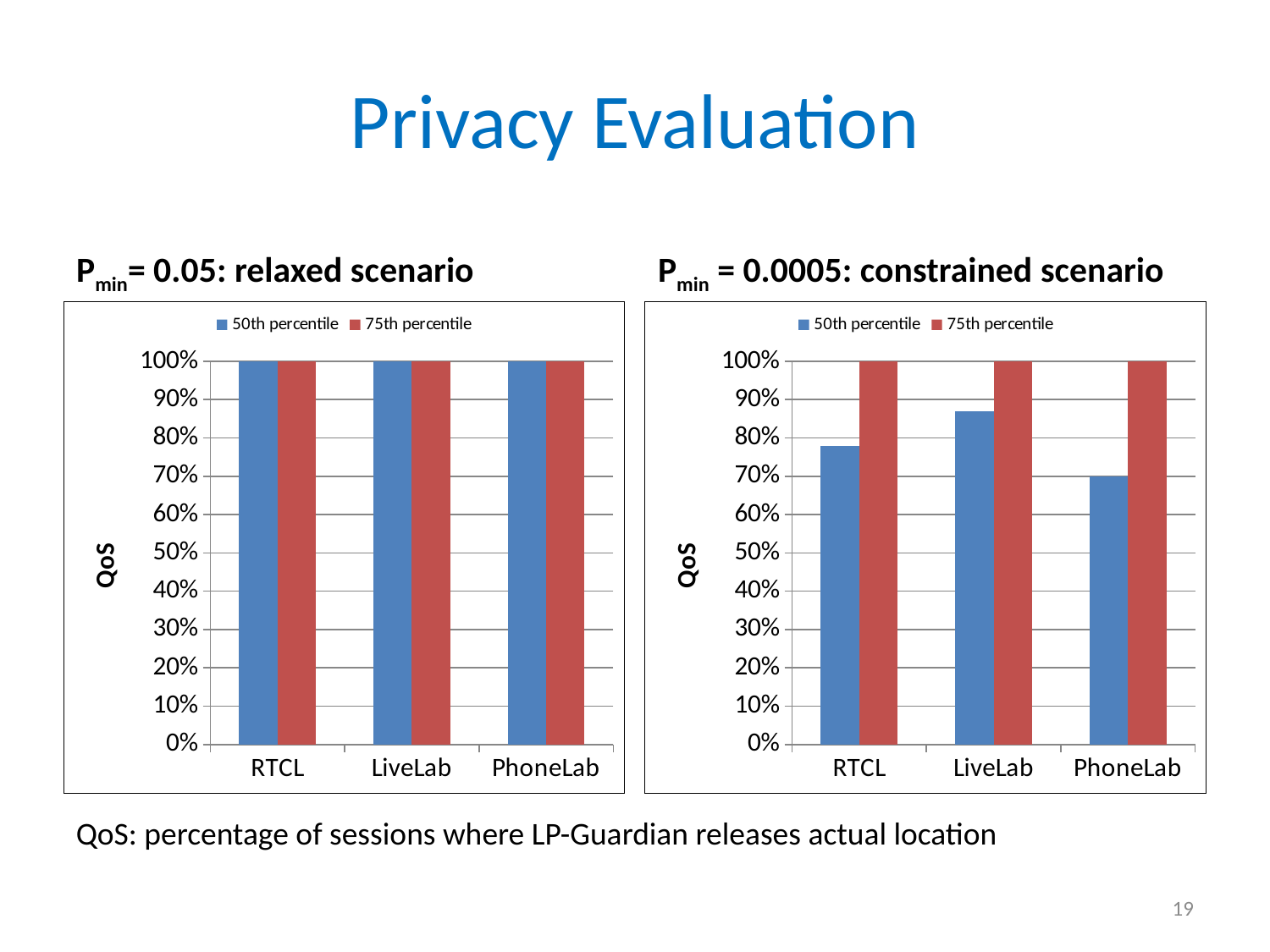
What is the y-axis label on the constrained scenario chart (right)? QoS In the constrained scenario chart (right), do the 50th percentile values rise or fall from LiveLab to PhoneLab? fall In the constrained scenario chart (right), is the 50th percentile value for RTCL greater or less than 70%? greater In the constrained scenario chart (right), is the 50th percentile value for LiveLab greater or less than 90%? less In the relaxed scenario chart (left), what is the 50th percentile QoS value for RTCL? 100% How many series does the legend of the constrained scenario chart (right) list? 2 In the constrained scenario chart (right), what is the 75th percentile QoS value for LiveLab? 100% How many categories are shown on the x axis of the relaxed scenario chart (left)? 3 In the constrained scenario chart (right), which is larger for RTCL: the 50th percentile or the 75th percentile value? 75th percentile What type of chart is used for the relaxed scenario (left)? Bar chart In the constrained scenario chart (right), which category has the highest 50th percentile QoS? LiveLab In the constrained scenario chart (right), which category has the lowest 50th percentile QoS? PhoneLab